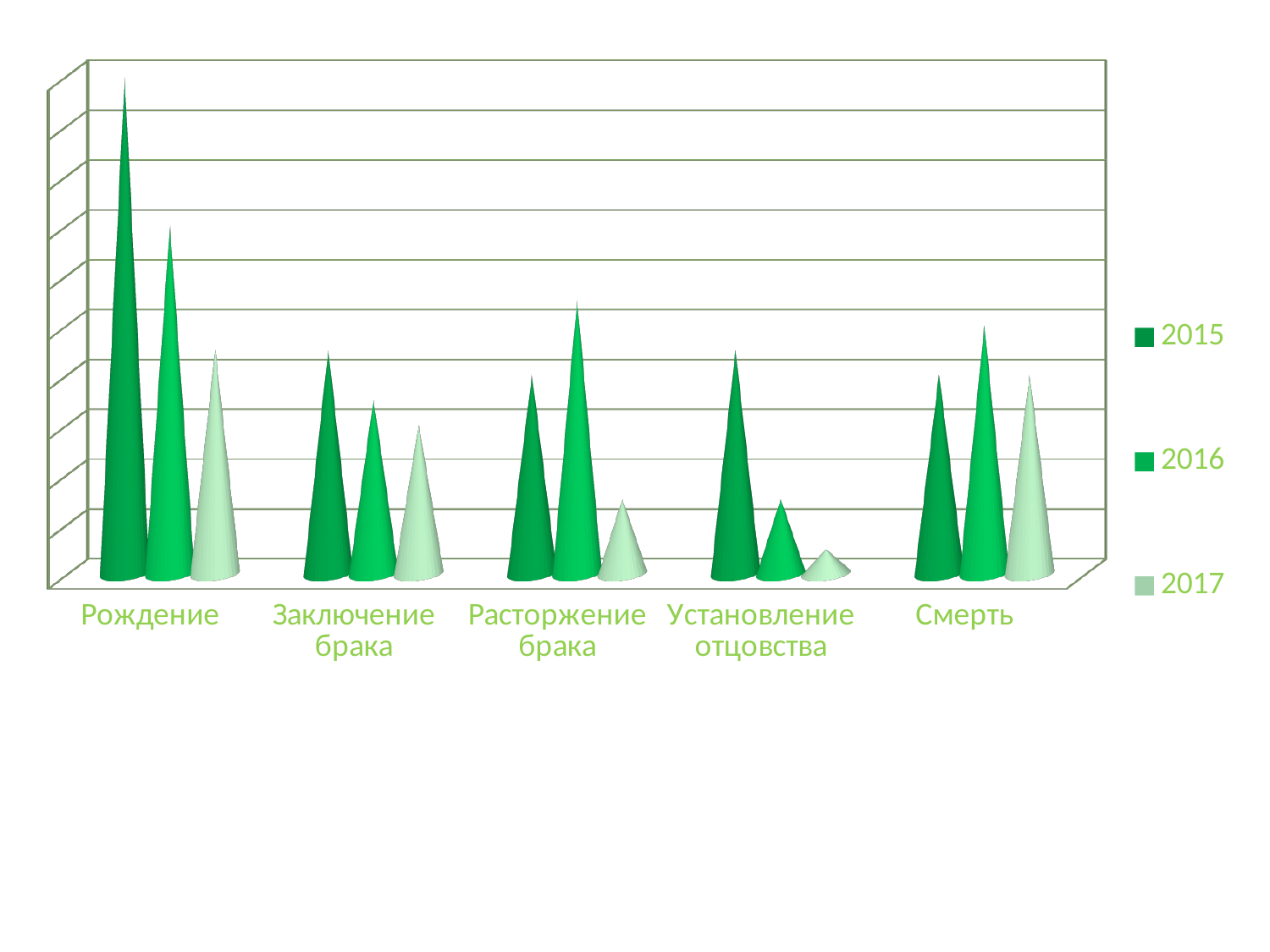
For Смерть, which is larger: the 2016 value or the 2017 value? 2016 For Расторжение брака, which is larger: the 2015 value or the 2016 value? 2016 What kind of chart is shown on the slide? bar chart Which category has the highest value for the 2015 series? Рождение Which category has the highest value for the 2016 series? Рождение For Рождение, which is larger: the 2015 value or the 2016 value? 2015 How many series does the chart's legend list? 3 Which category has the lowest value for the 2016 series? Установление отцовства Which years are listed in the chart's legend? 2015, 2016, 2017 How many categories are shown on the x axis of the chart? 5 For Рождение, do the values rise or fall from 2015 to 2017? fall Which category has the lowest value for the 2017 series? Установление отцовства